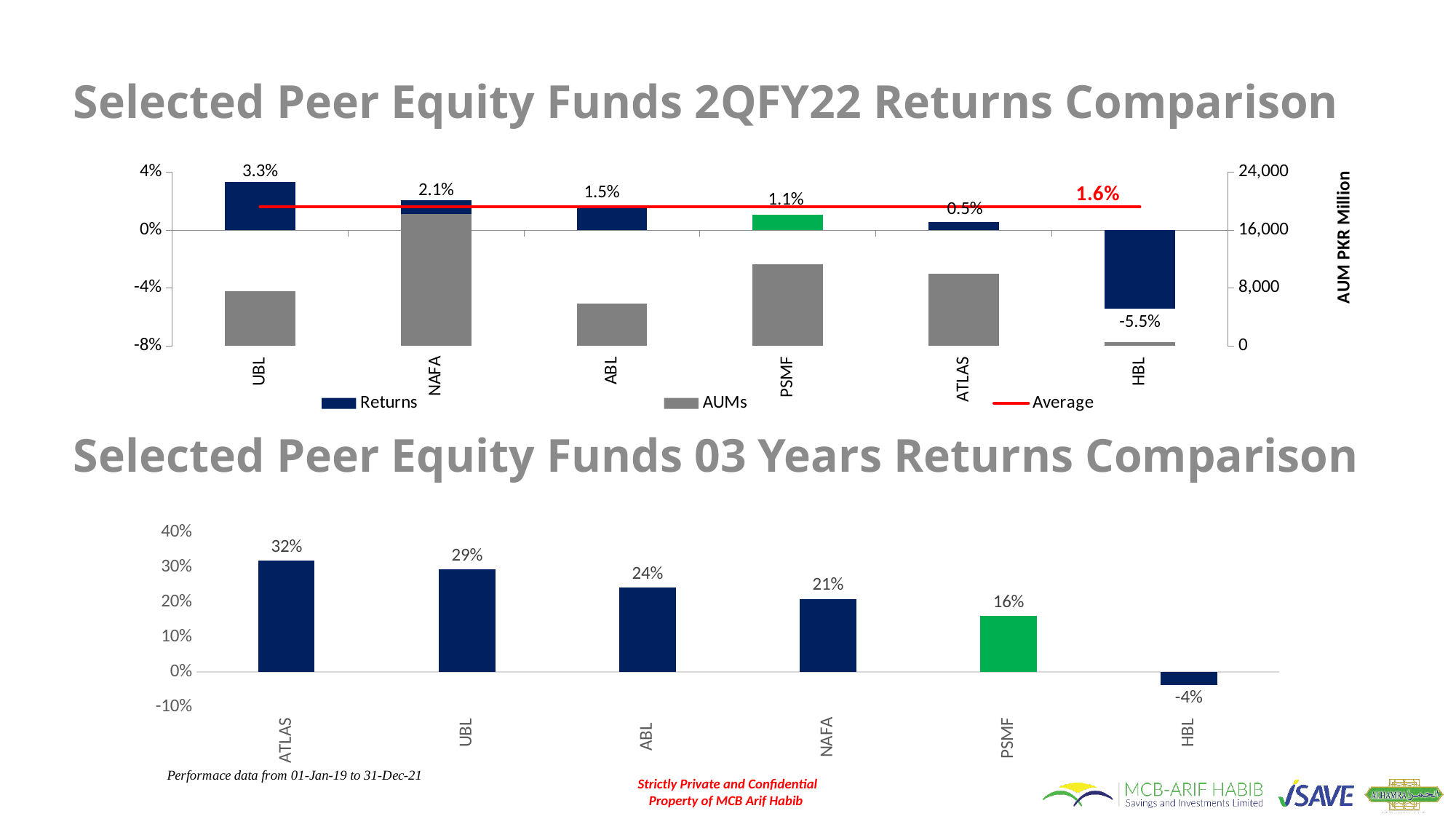
In the 2QFY22 Returns Comparison chart, is the AUM for ABL greater or less than 8,000? less In the 2QFY22 Returns Comparison chart, what is the return for UBL? 3.3% In the 03 Years Returns Comparison chart, what is the difference between the returns of UBL and PSMF? 13% In the 2QFY22 Returns Comparison chart, is the AUM for NAFA greater or less than 16,000? greater In the 03 Years Returns Comparison chart, which fund has the lowest return? HBL In the 03 Years Returns Comparison chart, how many funds are shown? 6 In the 2QFY22 Returns Comparison chart, what is the difference between the returns of UBL and NAFA? 1.2% In the 2QFY22 Returns Comparison chart, what is the return for HBL? -5.5% In the 03 Years Returns Comparison chart, what is the return for ATLAS? 32% In the 2QFY22 Returns Comparison chart, which fund has the highest AUM? NAFA In the 2QFY22 Returns Comparison chart, what is the value of the Average line? 1.6% In the 2QFY22 Returns Comparison chart, how many series does the legend list? 3